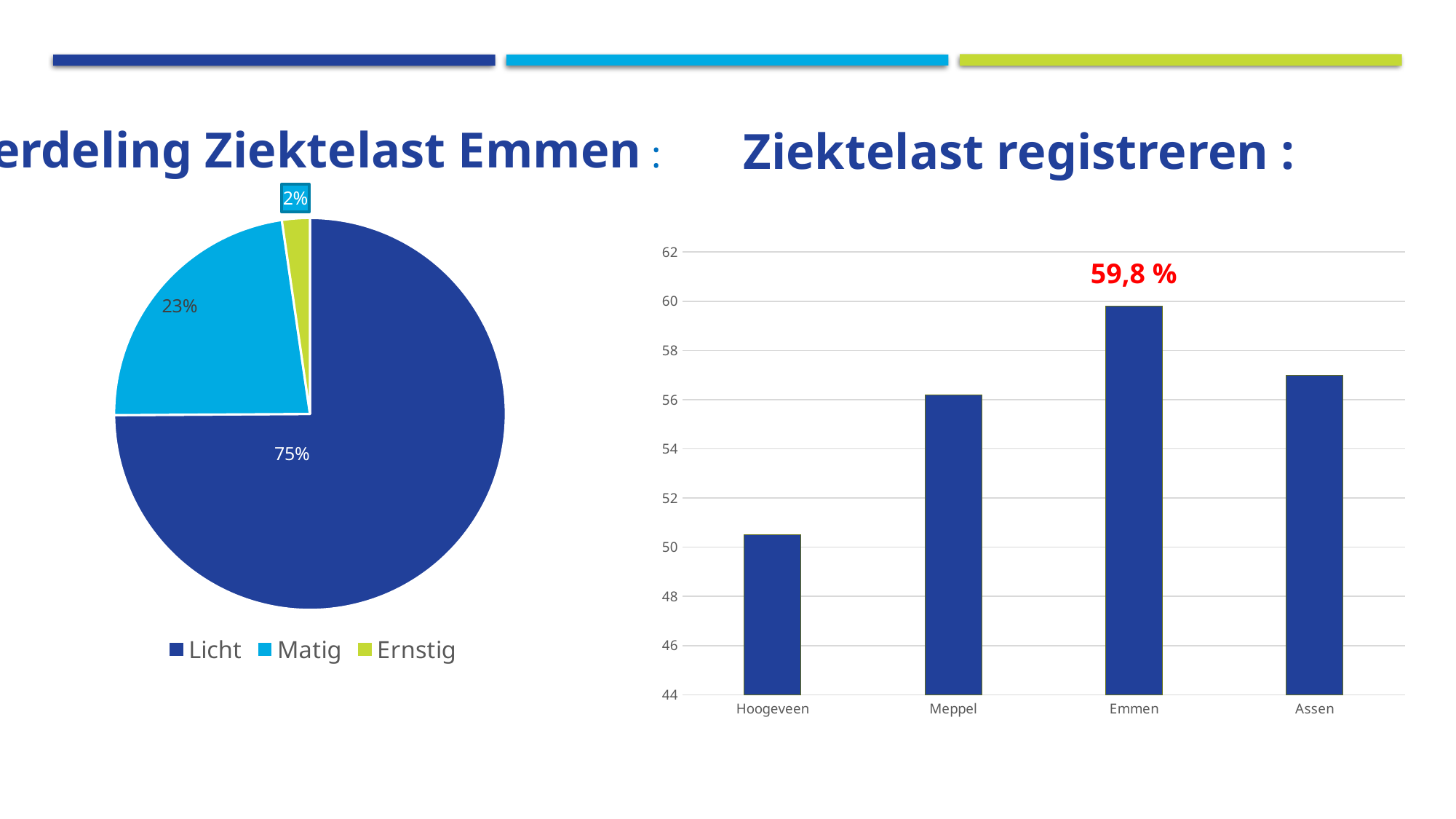
In the 'Ziektelast registreren' chart on the right, which municipality has the lowest bar? Hoogeveen In the 'Ziektelast registreren' chart on the right, which municipality has the highest bar? Emmen In the 'Ziektelast registreren' chart on the right, is the value for Hoogeveen greater or less than 52? less In the pie chart on the left, which category has the smallest slice? Ernstig In the pie chart on the left, what share does Licht have? 75% What kind of chart is shown on the right side of the slide? bar chart In the pie chart on the left, what share does Ernstig have? 2% In the pie chart on the left, what share does Matig have? 23% In the 'Ziektelast registreren' chart on the right, which is larger, the value for Assen or the value for Meppel? Assen In the pie chart on the left, how many categories does the legend list? 3 In the pie chart on the left, which category has the largest slice? Licht In the 'Ziektelast registreren' chart on the right, what is the value for Emmen? 59,8 %